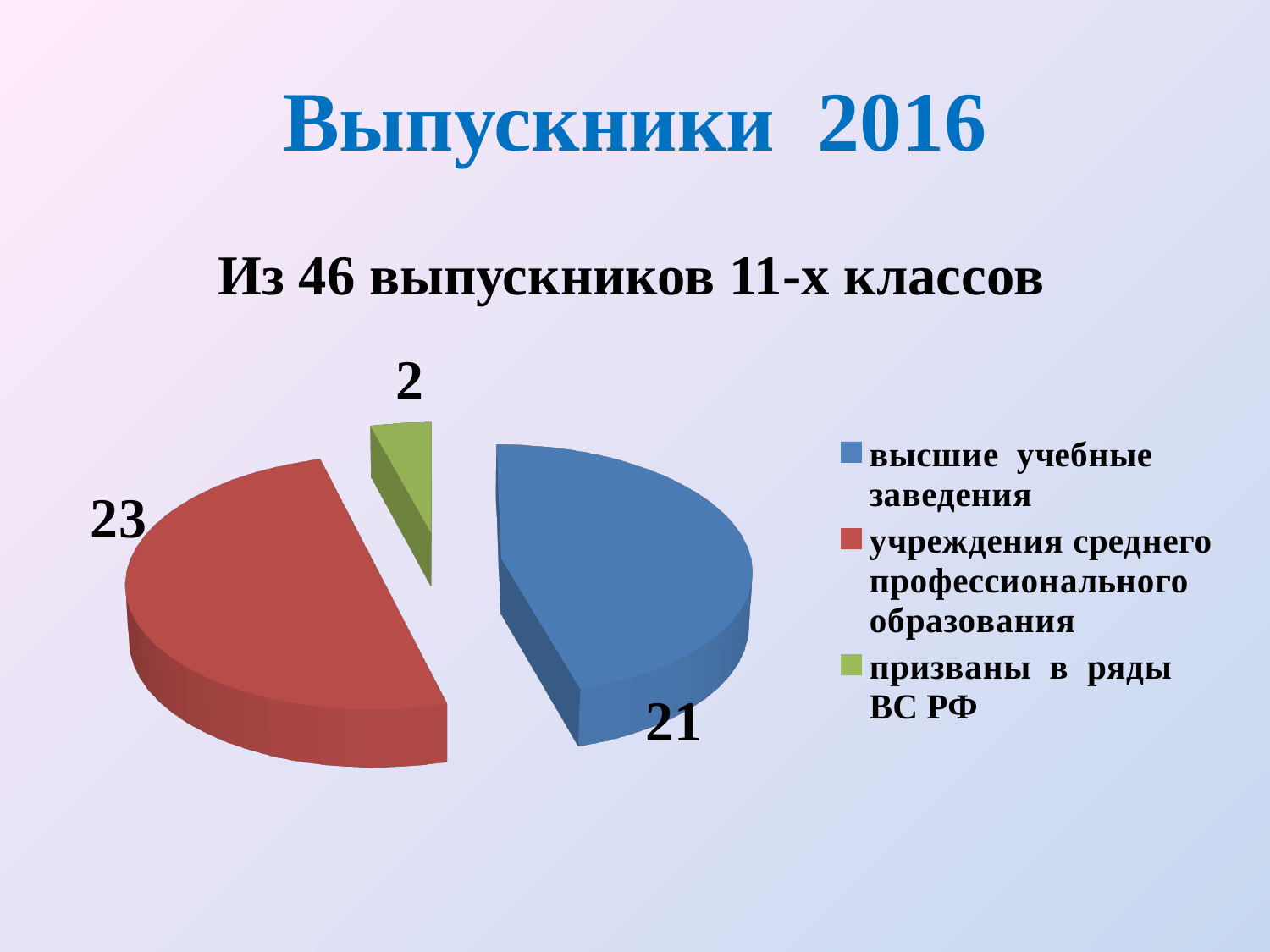
How many graduates went to secondary vocational education institutions (учреждения среднего профессионального образования)? 23 What colour is the slice for graduates drafted into the Armed Forces (призваны в ряды ВС РФ)? green What is the total of all slices in the pie chart? 46 What type of chart is shown on the slide? pie chart How many graduates were drafted into the Russian Armed Forces (призваны в ряды ВС РФ)? 2 Which category has the smallest slice of the pie? призваны в ряды ВС РФ What is the difference between the number of graduates in secondary vocational education and those in higher education institutions? 2 What share of the pie does the secondary vocational education slice (23) represent? 50% Which is larger: the number of graduates in higher education institutions or the number drafted into the Armed Forces? высшие учебные заведения How many graduates went to higher education institutions (высшие учебные заведения)? 21 How many categories does the pie chart have? 3 Which category has the largest slice of the pie? учреждения среднего профессионального образования